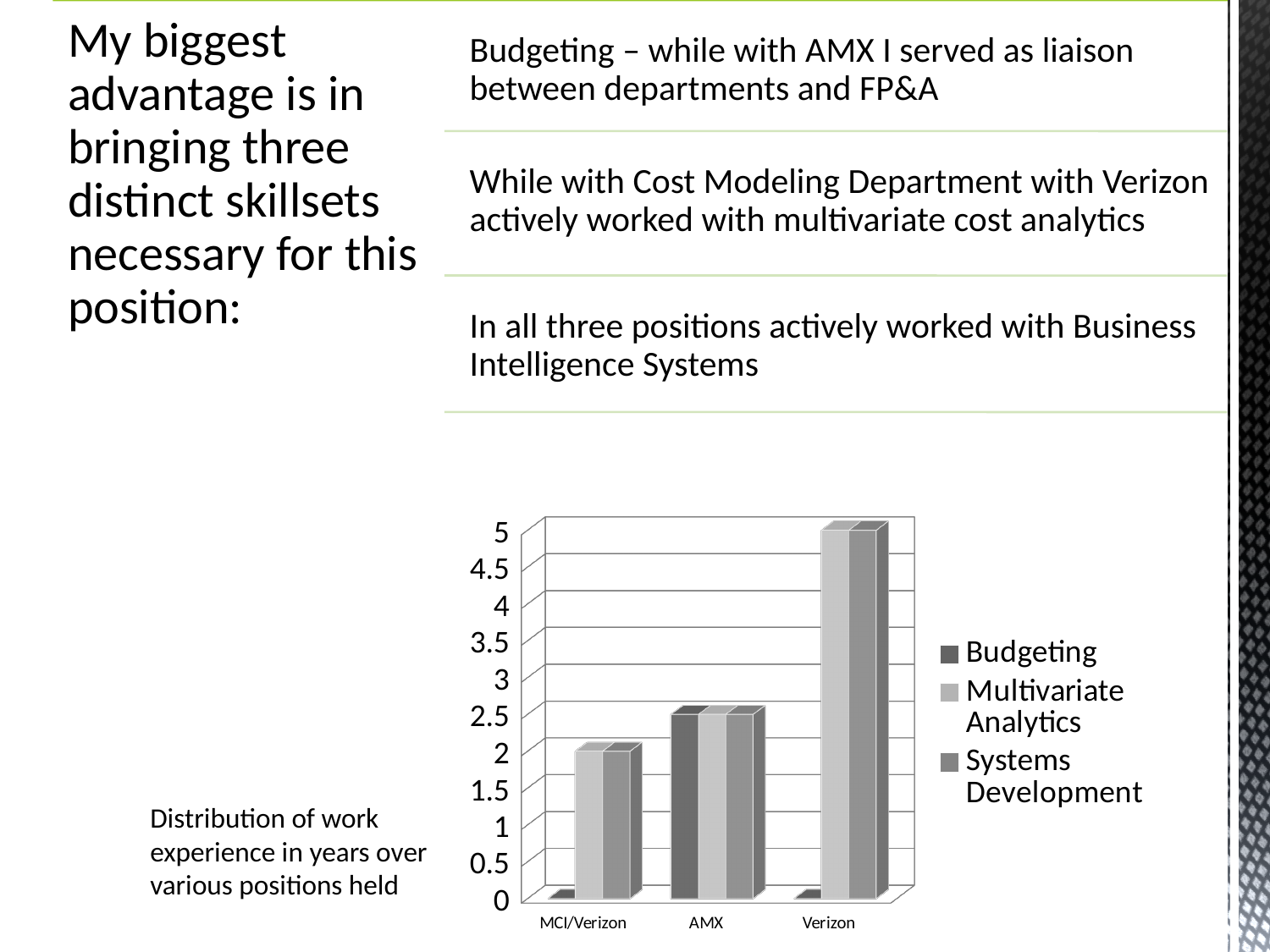
What kind of chart is shown on the slide? bar chart Which is larger, the Multivariate Analytics value for Verizon or for AMX? Verizon Is the Multivariate Analytics value for Verizon greater or less than 4? greater What is the caption describing the chart? Distribution of work experience in years over various positions held Which category has the lowest Multivariate Analytics value? MCI/Verizon Is the Budgeting value for MCI/Verizon greater or less than 1? less Is the Budgeting value for AMX greater or less than 2? greater How many series does the chart legend list? 3 How many categories are shown on the x axis of the chart? 3 Which series are listed in the chart legend? Budgeting, Multivariate Analytics, Systems Development Which category has the highest Systems Development value? Verizon